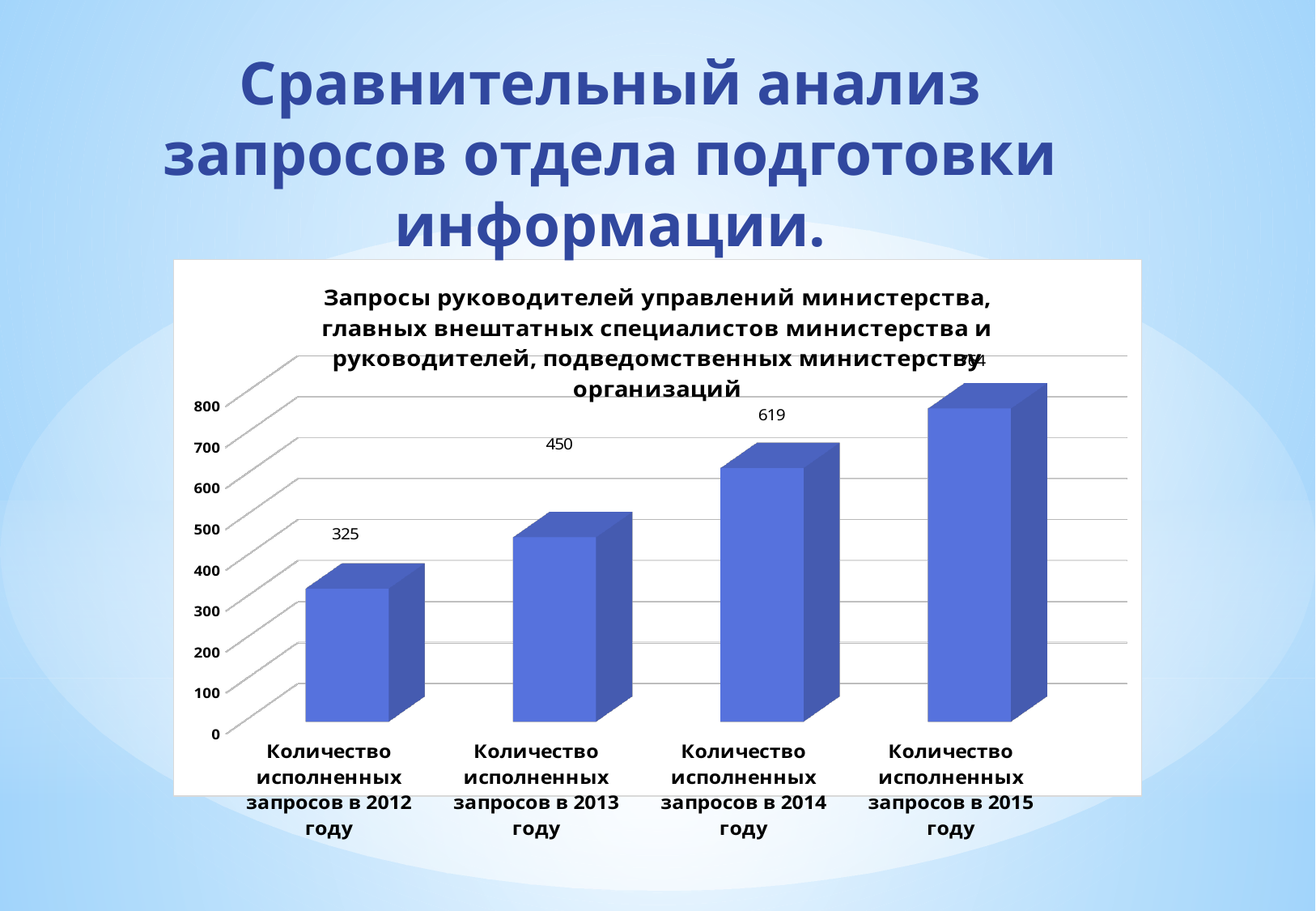
Which year has the highest number of completed requests? 2015 What is the difference between the number of completed requests in 2014 and in 2013? 169 What is the difference between the number of completed requests in 2013 and in 2012? 125 Which year has the lowest number of completed requests? 2012 What is the number of completed requests in 2012 (Количество исполненных запросов в 2012 году)? 325 How many categories (years) are shown in the chart? 4 Is the value for completed requests in 2015 greater or less than 700? greater What is the number of completed requests in 2013 (Количество исполненных запросов в 2013 году)? 450 Do the values rise or fall from 2012 to 2015? rise What is the number of completed requests in 2014 (Количество исполненных запросов в 2014 году)? 619 Which is larger: the number of completed requests in 2014 or in 2012? 2014 What kind of chart is shown on the slide? bar chart